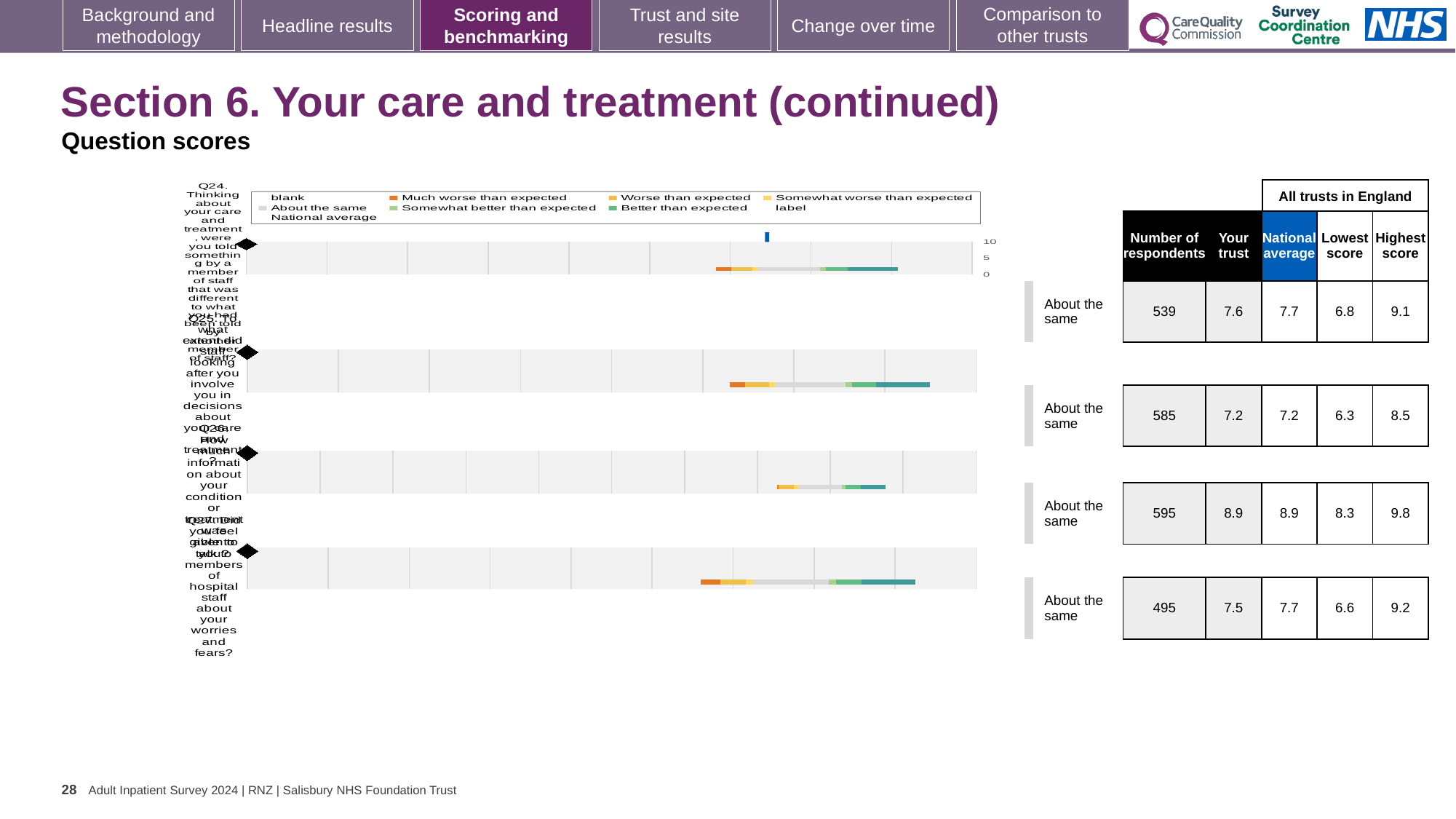
What is the difference between the 'Your trust' score and the 'National average' for Q27 in the table? 0.2 Which legend entry is shown in light grey in the chart legend? About the same How many question charts (Q24 to Q27) are shown on the slide? 4 What benchmark category label is shown next to the Q27 chart? About the same In the table beside the Q24 chart, what is the 'Your trust' score? 7.6 Which legend entry is shown in orange in the chart legend? Much worse than expected In the table beside the Q25 chart, what is the number of respondents? 585 In the table beside the Q26 chart, what is the 'Your trust' score? 8.9 Which question's table row has the lowest 'Your trust' score: Q24, Q25, Q26 or Q27? Q25 Which question's table row has the highest 'Your trust' score: Q24, Q25, Q26 or Q27? Q26 What benchmark category label is shown next to the Q24 chart? About the same What kind of chart is used to show the question scores on this slide? bar chart